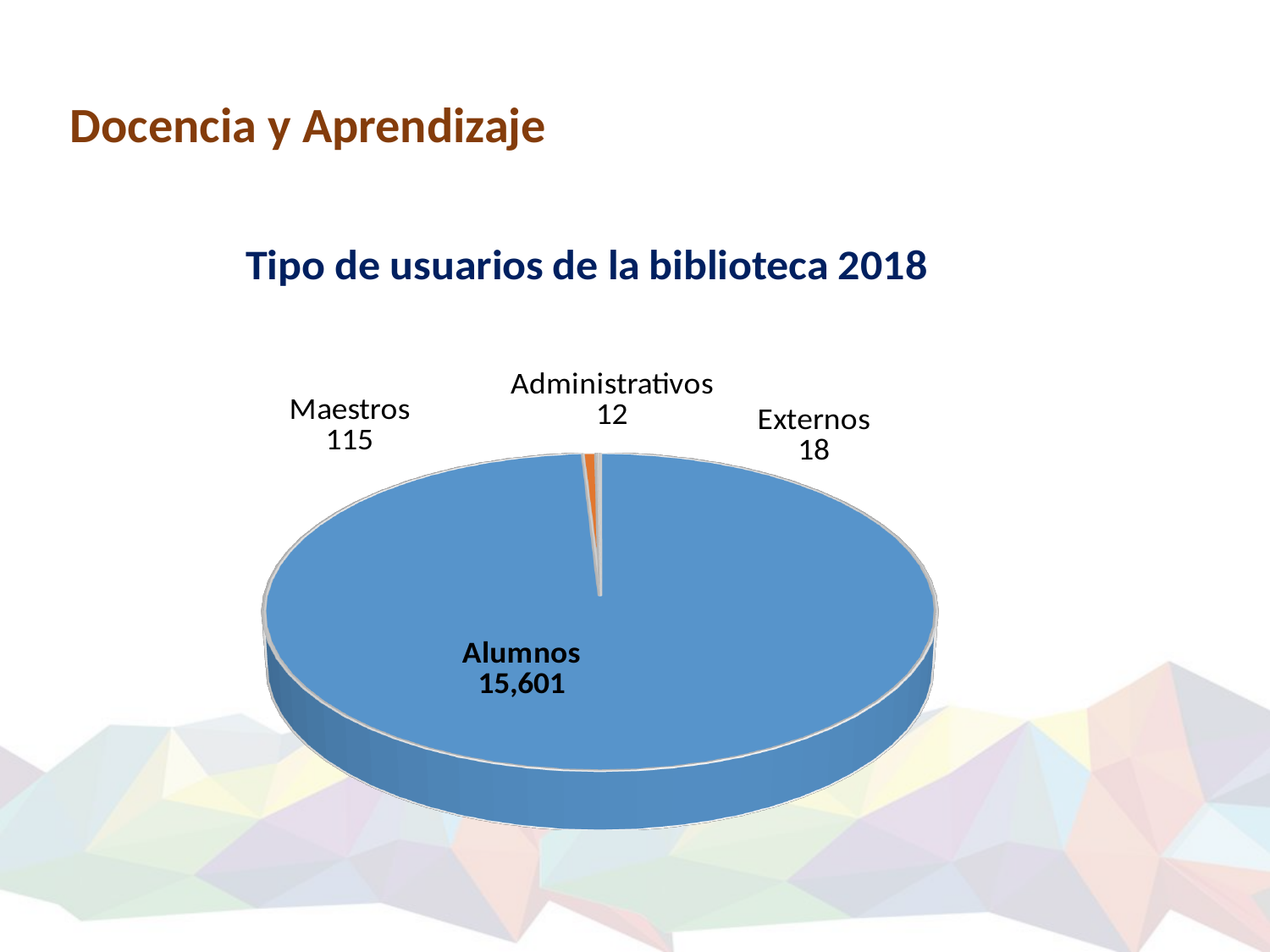
What is the value for Externos? 18 Which is larger, Maestros or Externos? Maestros How many categories does the pie chart show? 4 What is the title of the chart? Tipo de usuarios de la biblioteca 2018 What is the total of all four categories in the pie chart? 15,746 What type of chart is shown on the slide? pie chart What is the value for Administrativos? 12 What is the difference between the values for Maestros and Externos? 97 Which category has the highest value? Alumnos Which category has the lowest value? Administrativos What is the value for Alumnos? 15,601 What is the value for Maestros? 115